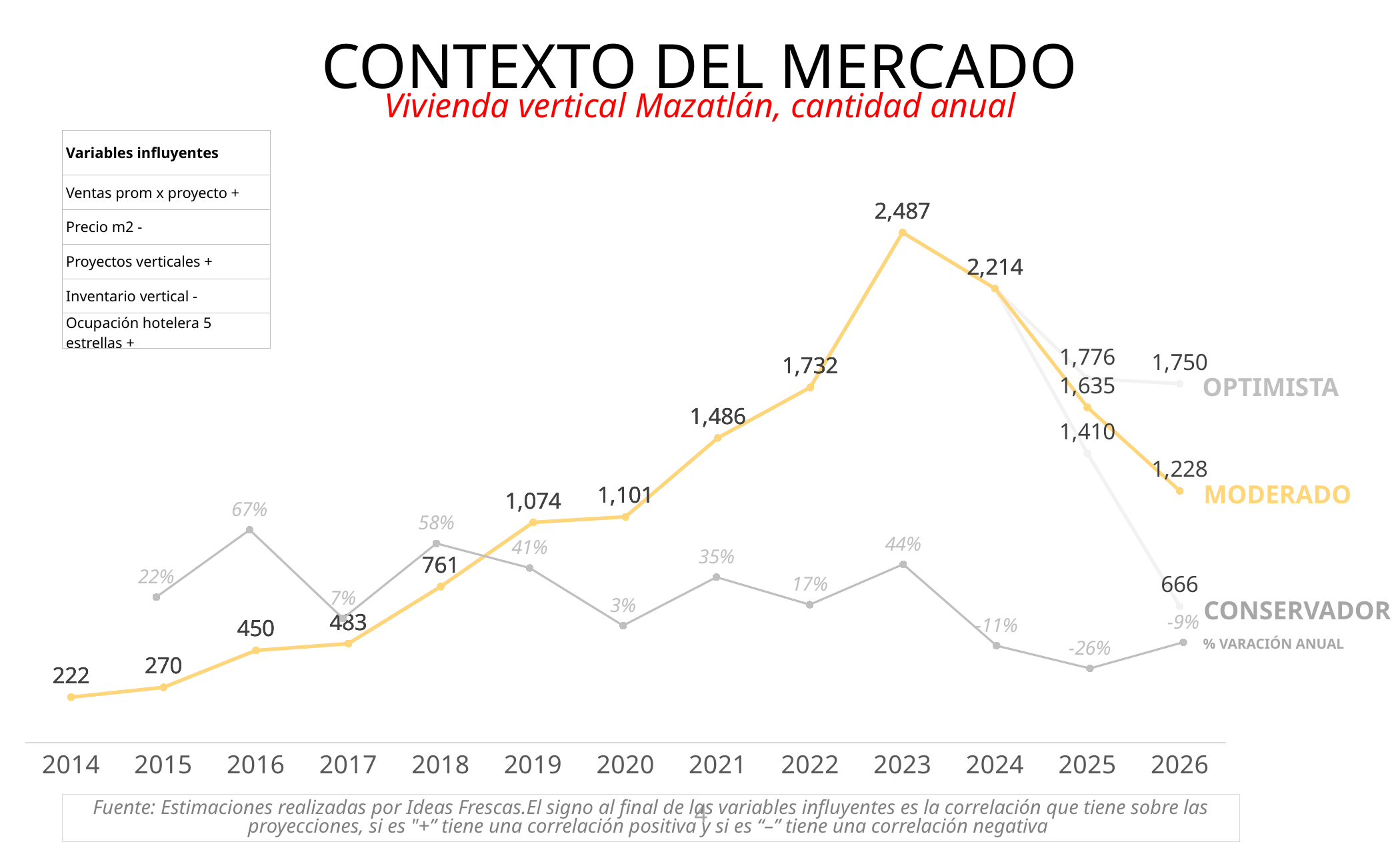
Which year has the larger value, 2019 or 2020? 2020 What is the CONSERVADOR value for 2026? 666 In which year is the main (MODERADO) line at its lowest value? 2014 How many years are shown on the x axis? 13 What is the difference between the 2023 value (2,487) and the 2024 value (2,214)? 273 Which year has the highest % variación anual? 2016 What kind of chart is this? Line chart In which year does the main (MODERADO) line reach its highest value? 2023 What is the value shown for 2023 on the main (MODERADO) line? 2,487 What is the value shown for 2014? 222 What is the OPTIMISTA value for 2026? 1,750 Do the values on the main (MODERADO) line rise or fall from 2014 to 2023? Rise